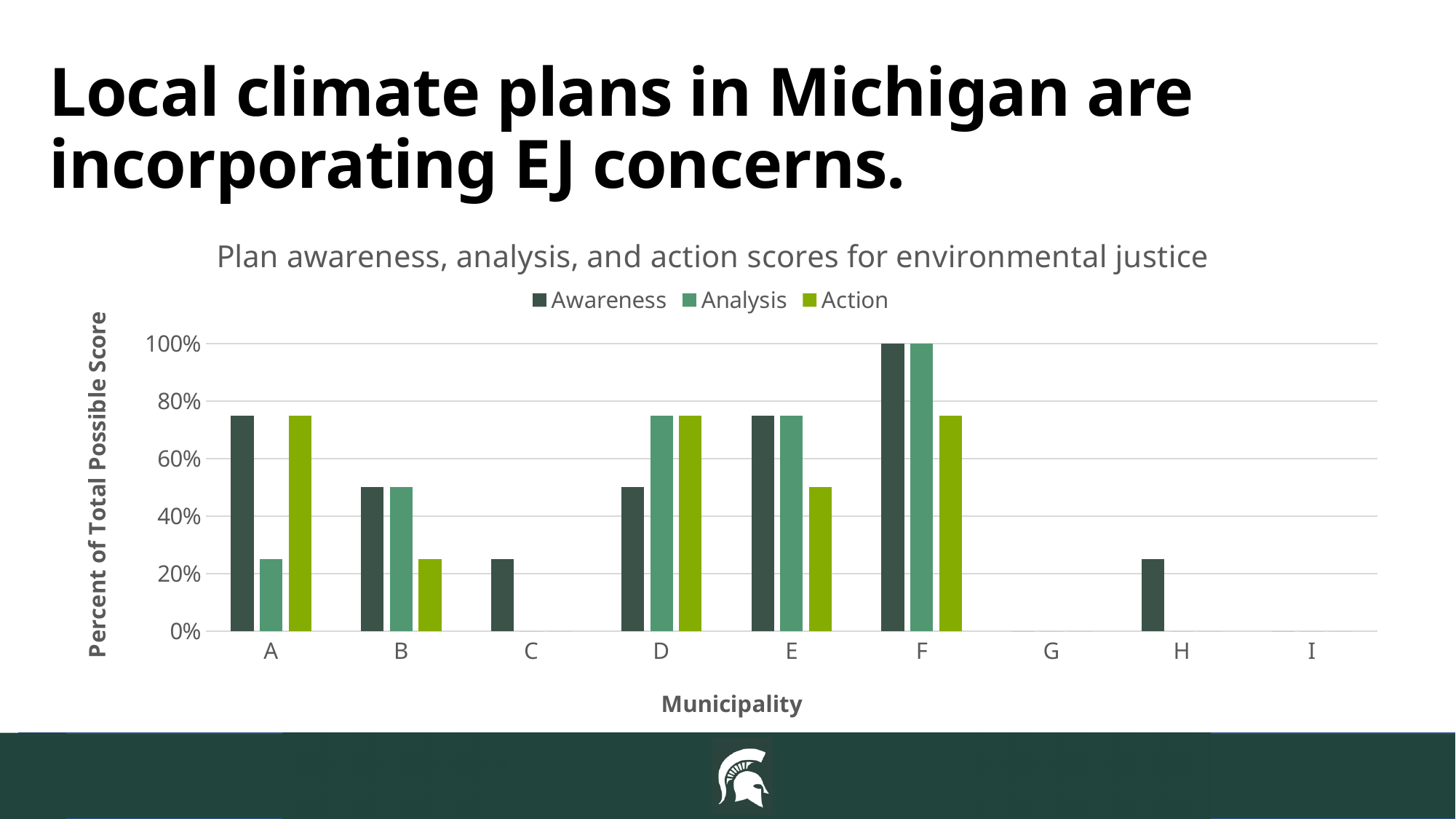
What kind of chart is shown on the slide? bar chart Is the Action value for municipality B greater or less than 40%? less How many series does the legend list? 3 How many municipalities are shown on the x axis? 9 Is the Awareness value for municipality A greater or less than 60%? greater Which is larger for municipality E, the Analysis value or the Action value? Analysis What is the Awareness value for municipality F? 100% Which municipality has the highest Awareness score? F Is the Analysis value for municipality A greater or less than 40%? less What is the Analysis value for municipality F? 100% What is the title of the chart? Plan awareness, analysis, and action scores for environmental justice Which is larger for municipality D, the Awareness value or the Analysis value? Analysis